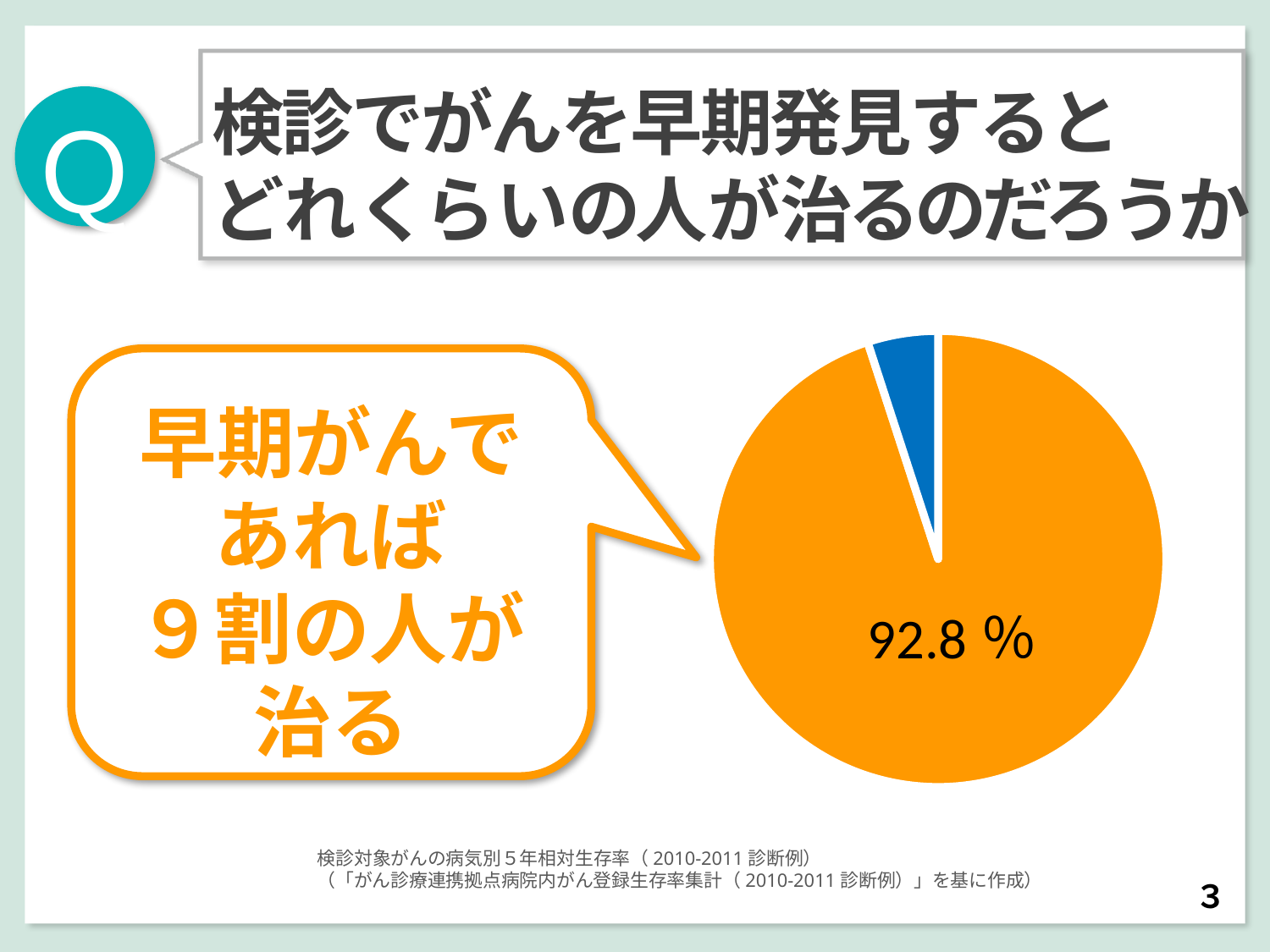
How many slices of the pie chart have a printed data label? 1 What value is printed on the large orange slice of the pie chart? 92.8 % Which slice of the pie chart is larger, the orange one or the blue one? orange What colour is the slice that carries the 92.8 % label? orange Is the labelled slice of the pie chart greater or less than 50%? greater Which colour slice is the smallest in the pie chart? blue How many slices does the pie chart have? 2 Which colour slice is the largest in the pie chart? orange What kind of chart is shown on the slide? pie chart Is the blue slice of the pie chart greater or less than 10%? less